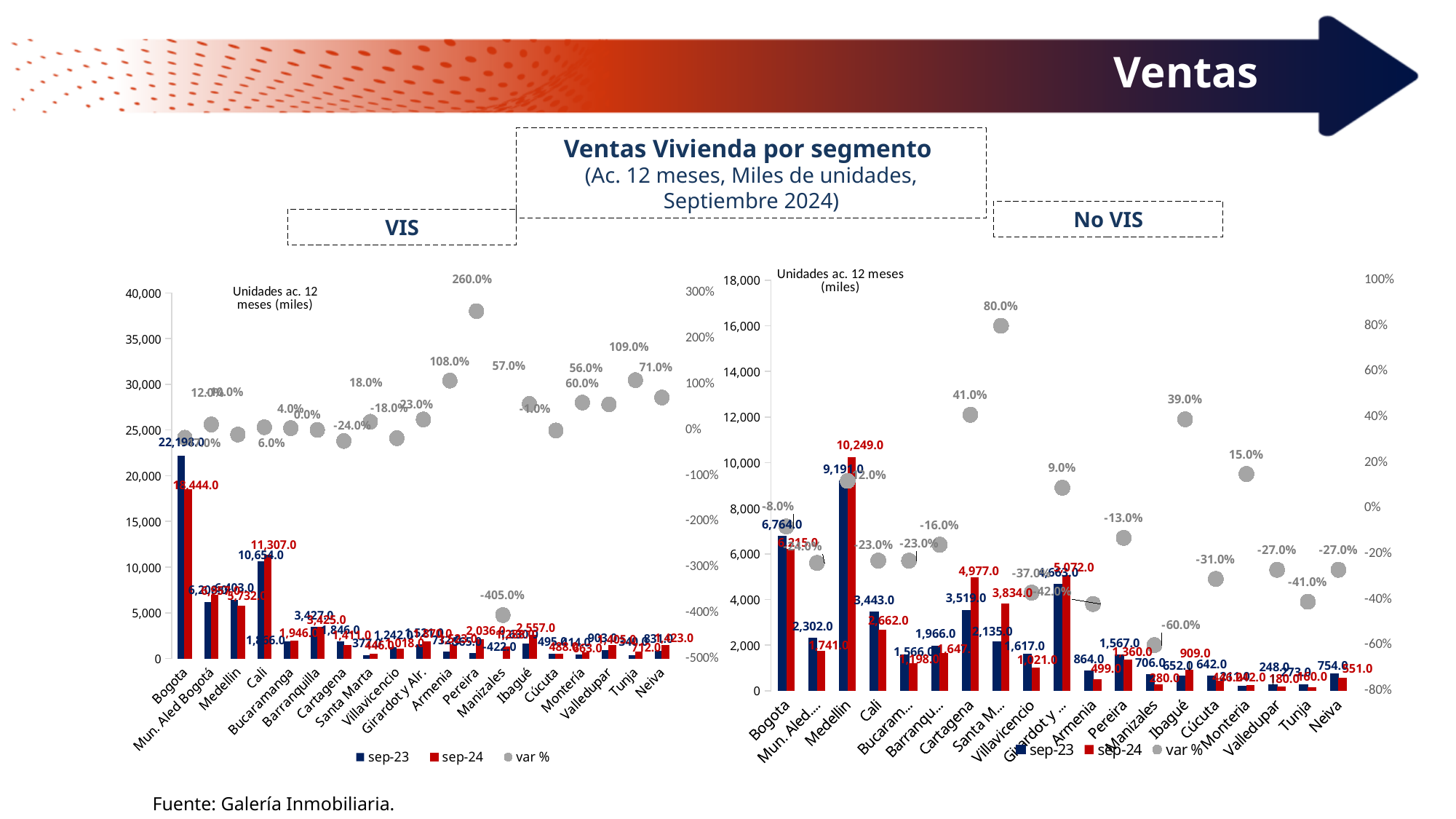
In the No VIS chart, what is the sep-23 value for Cartagena? 3,519.0 What kind of chart is used for the sep-23 and sep-24 series in the No VIS chart? bar chart In the VIS chart, what is the var % for Pereira? 260.0% What is the title shown above the two charts? Ventas Vivienda por segmento In the VIS chart, which is larger for Cali: the sep-23 value or the sep-24 value? sep-24 In the No VIS chart, which city has the highest var %? Santa Marta In the No VIS chart, what is the sep-24 value for Medellin? 10,249.0 In the VIS chart, what is the sep-23 value for Bogota? 22,198.0 In the No VIS chart, what is the difference between the sep-24 and sep-23 values for Medellin? 1,058.0 In the No VIS chart, is the sep-23 value for Girardot greater or less than 4,000? greater How many series does the legend of the VIS chart list? 3 In the No VIS chart, which city has the lowest var %? Manizales